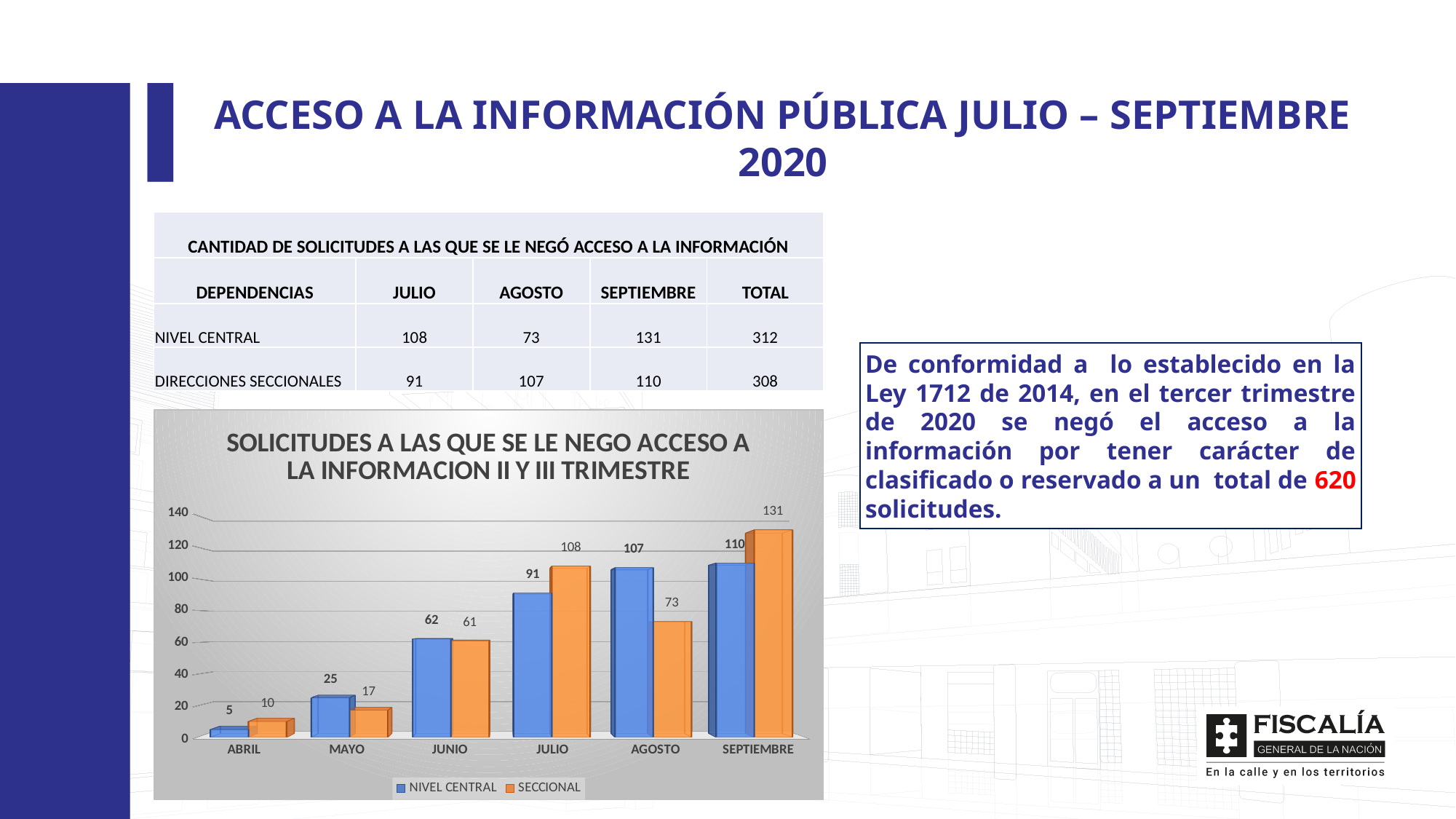
What is the value for NIVEL CENTRAL in JUNIO? 62 How many series does the chart legend list? 2 How many months are shown on the x axis of the chart? 6 Which month has the lowest value for SECCIONAL? ABRIL In AGOSTO, which series has the larger value, NIVEL CENTRAL or SECCIONAL? NIVEL CENTRAL Which month has the highest value for NIVEL CENTRAL? SEPTIEMBRE What kind of chart is shown on the slide? Bar chart What is the difference between the SECCIONAL and NIVEL CENTRAL values in JULIO? 17 What is the value for SECCIONAL in SEPTIEMBRE? 131 What is the value for SECCIONAL in AGOSTO? 73 Is the value for NIVEL CENTRAL in MAYO greater or less than 40? less Do the NIVEL CENTRAL values rise or fall from ABRIL to SEPTIEMBRE? Rise